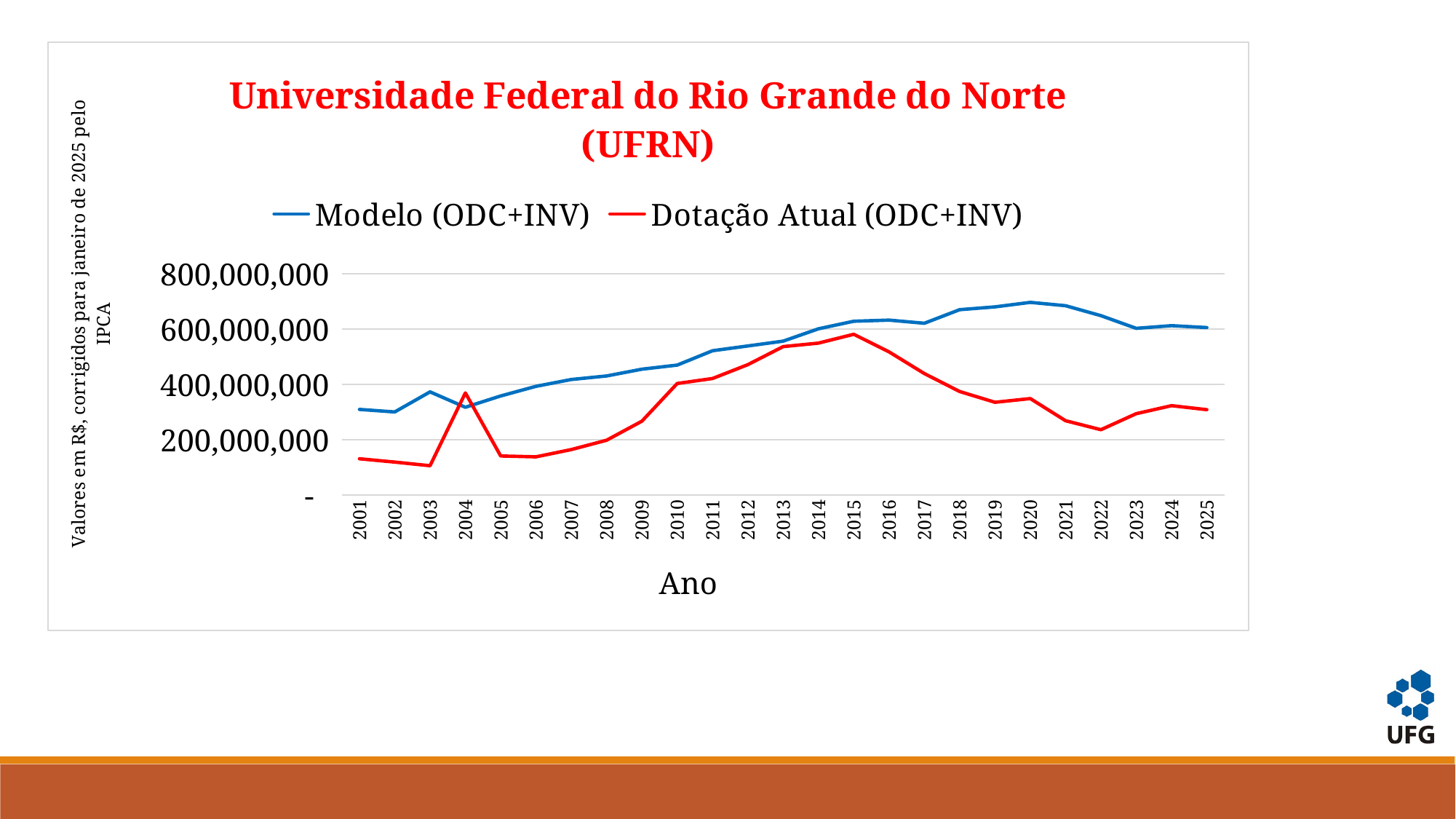
In which year does the Modelo (ODC+INV) series reach its highest value? 2020 What kind of chart is shown on the slide? Line chart In which year does the Dotação Atual (ODC+INV) series reach its lowest value? 2003 Is the value for Modelo (ODC+INV) in 2020 greater or less than 600,000,000? greater Does the Dotação Atual (ODC+INV) series rise or fall between 2015 and 2022? Fall Is the value for Dotação Atual (ODC+INV) in 2015 greater or less than 400,000,000? greater How many series does the legend list? 2 How many years are plotted along the x axis? 25 In 2010, which series has the larger value, Modelo (ODC+INV) or Dotação Atual (ODC+INV)? Modelo (ODC+INV) In which year does the Dotação Atual (ODC+INV) series reach its highest value? 2015 Is the value for Dotação Atual (ODC+INV) in 2003 greater or less than 200,000,000? less What is the title of the chart? Universidade Federal do Rio Grande do Norte (UFRN)